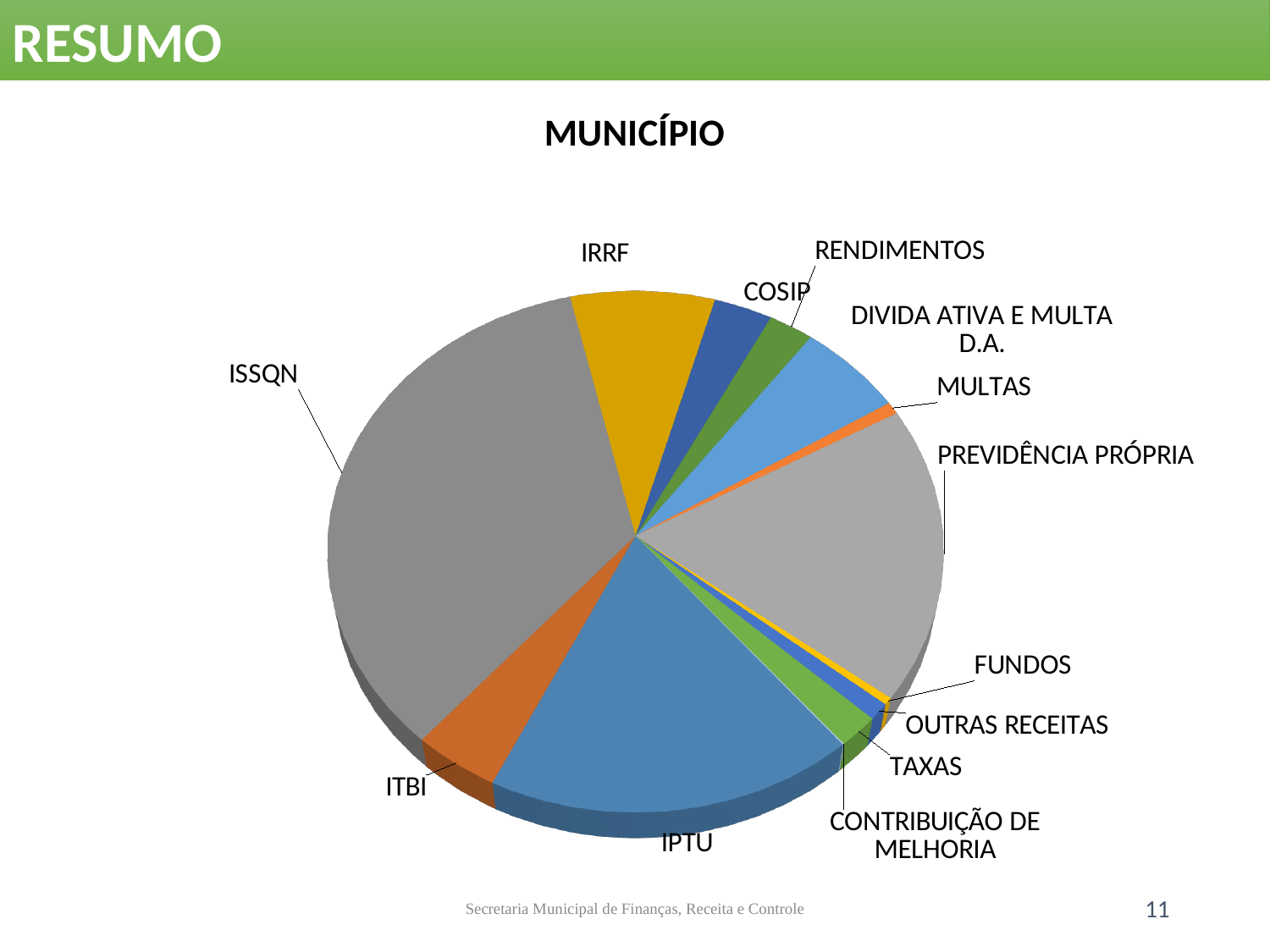
Which slice is larger, PREVIDÊNCIA PRÓPRIA or FUNDOS? PREVIDÊNCIA PRÓPRIA Which category has the largest slice of the pie? ISSQN What is the title of the chart? MUNICÍPIO What colour is the ISSQN slice? grey Which slice is larger, IRRF or COSIP? IRRF Which slice is larger, ISSQN or IPTU? ISSQN What kind of chart is shown on the slide? pie chart How many categories (slices) does the pie chart have? 13